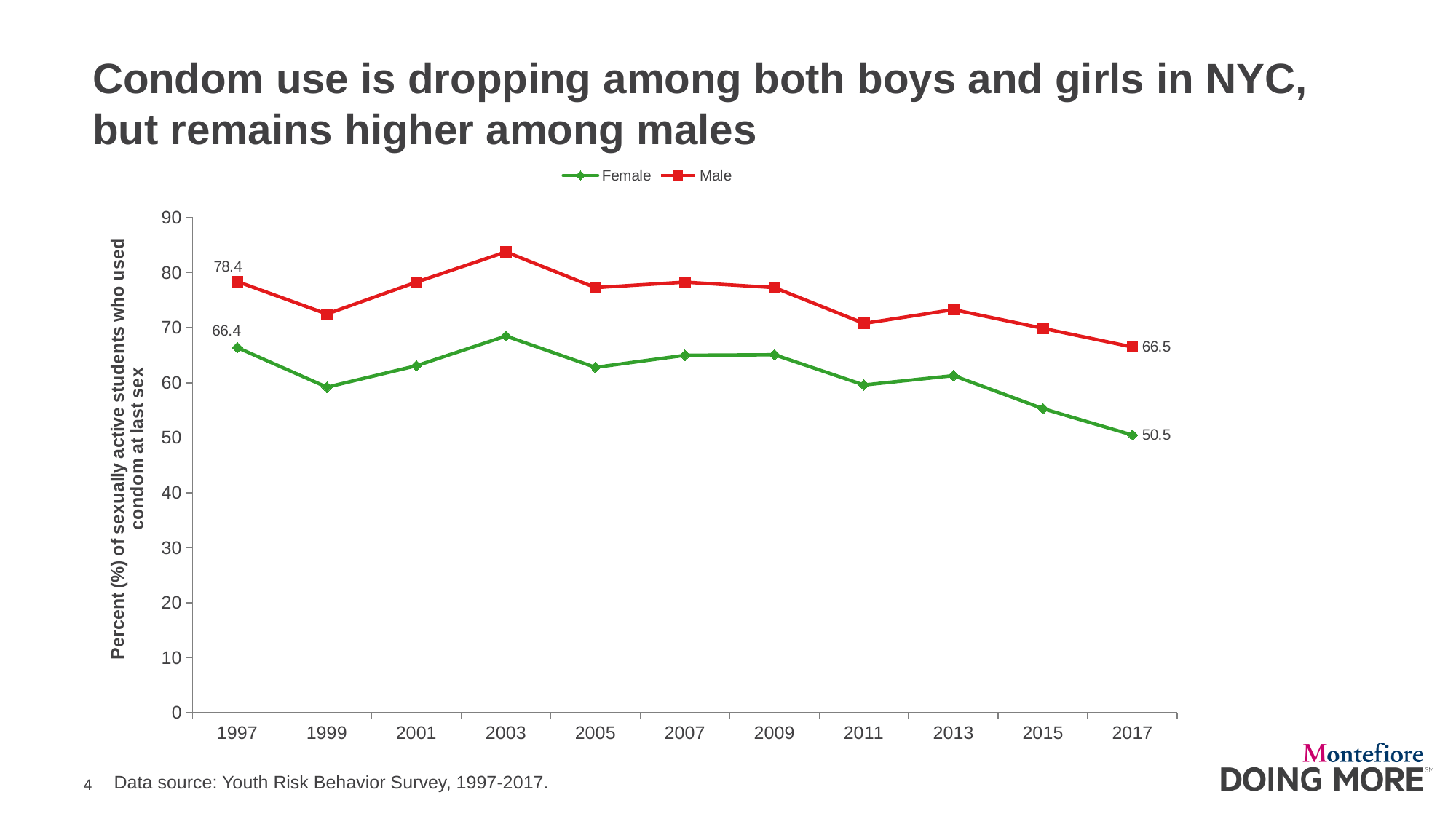
What is the value for Female in 2017? 50.5 What kind of chart is shown on the slide? line chart How many series does the legend list? 2 What is the difference between the Male and Female values in 2017? 16.0 What is the value for Female in 1997? 66.4 What is the value for Male in 1997? 78.4 In which year is the Male series at its highest? 2003 What is the value for Male in 2017? 66.5 By how much did the Female value fall from 1997 to 2017? 15.9 Which series is higher in 2009, Female or Male? Male In which year is the Female series at its lowest? 2017 Is the value for Female in 2015 greater or less than 60? less